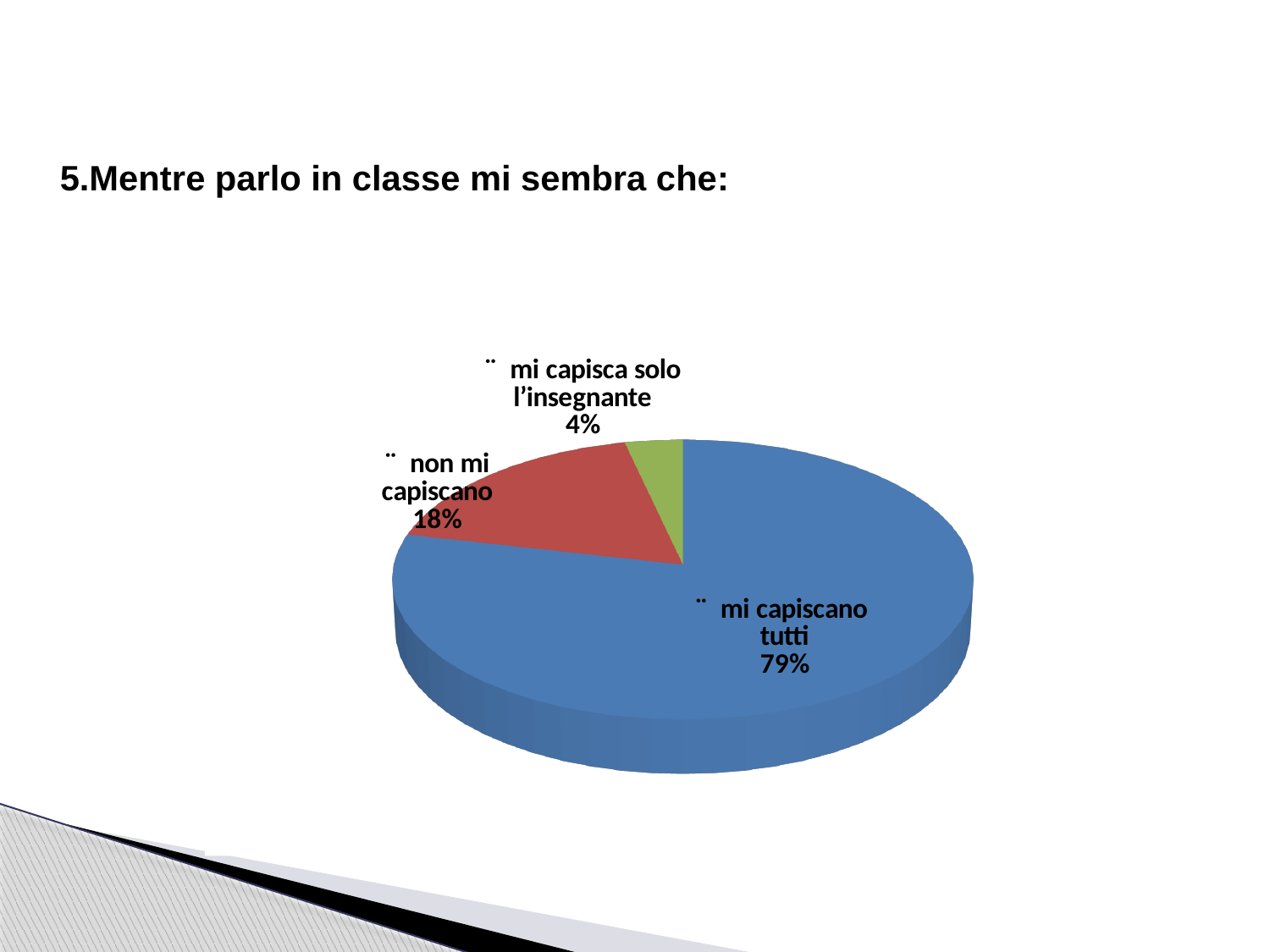
What colour is the slice for 'mi capiscano tutti'? blue What percentage of the pie is 'mi capisca solo l'insegnante'? 4% What is the title text above the chart? 5.Mentre parlo in classe mi sembra che: What kind of chart is shown on the slide? pie chart Which slice of the pie is the smallest? mi capisca solo l'insegnante Which slice of the pie is the largest? mi capiscano tutti What is the difference in percentage points between 'mi capiscano tutti' and 'non mi capiscano'? 61 Which is larger, the slice for 'non mi capiscano' or the slice for 'mi capisca solo l'insegnante'? non mi capiscano What is the difference in percentage points between 'non mi capiscano' and 'mi capisca solo l'insegnante'? 14 What percentage of the pie is 'mi capiscano tutti'? 79% What percentage of the pie is 'non mi capiscano'? 18% How many slices does the pie chart have? 3